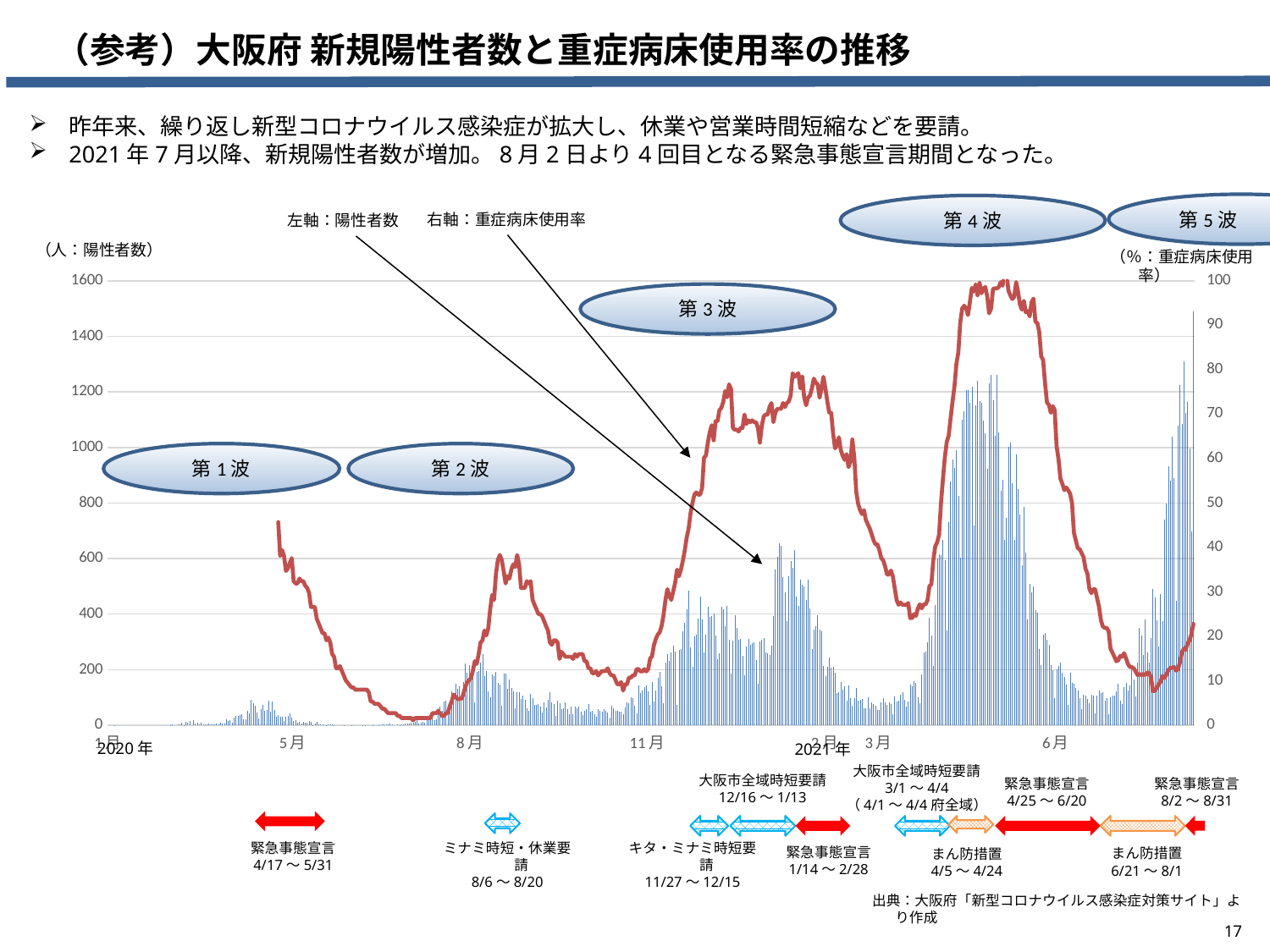
Is the peak severe bed usage rate (red line) during 第4波 greater or less than 90? greater What does the right axis of the chart represent? 重症病床使用率 Is the peak severe bed usage rate during 第2波 greater or less than 50? less After the peak of 第4波, does the severe bed usage rate rise or fall through June 2021? fall How many waves (第1波 to 第5波) are labelled on the chart? 5 What kind of chart is shown on the slide? bar and line chart Which wave had the higher peak of daily new positive cases, 第3波 or 第4波? 第4波 Is the peak daily number of new positive cases (blue bars) during 第4波 greater or less than 1000? greater How many data series are plotted on the chart (left axis and right axis)? 2 What is the title of the chart on the slide? （参考）大阪府 新規陽性者数と重症病床使用率の推移 Which wave had the higher peak severe bed usage rate, 第3波 or 第4波? 第4波